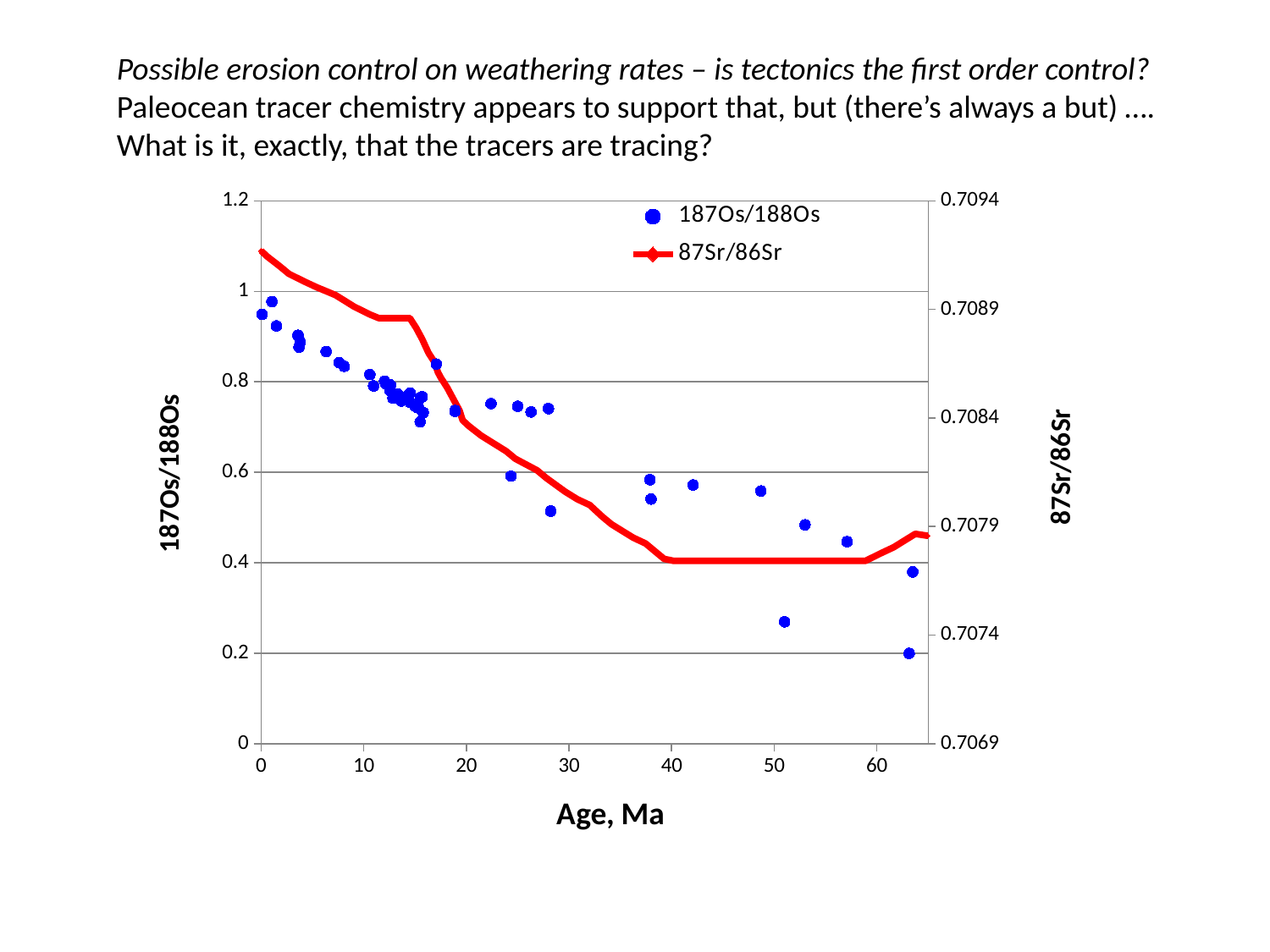
How many series does the legend list? 2 Do the 187Os/188Os values generally rise or fall as age increases along the x axis? fall Do the 87Sr/86Sr values generally rise or fall as age increases from 0 to 40 Ma? fall What is the title of the x axis? Age, Ma Which series is plotted as a red line? 87Sr/86Sr What kind of chart is shown on the slide? scatter chart Is the 87Sr/86Sr value at age 30 Ma greater or less than 0.7084? less Is the 187Os/188Os value at age 0 Ma greater or less than 0.8? greater Is the 87Sr/86Sr value at age 0 Ma greater or less than 0.7089? greater What are the two series named in the legend? 187Os/188Os and 87Sr/86Sr